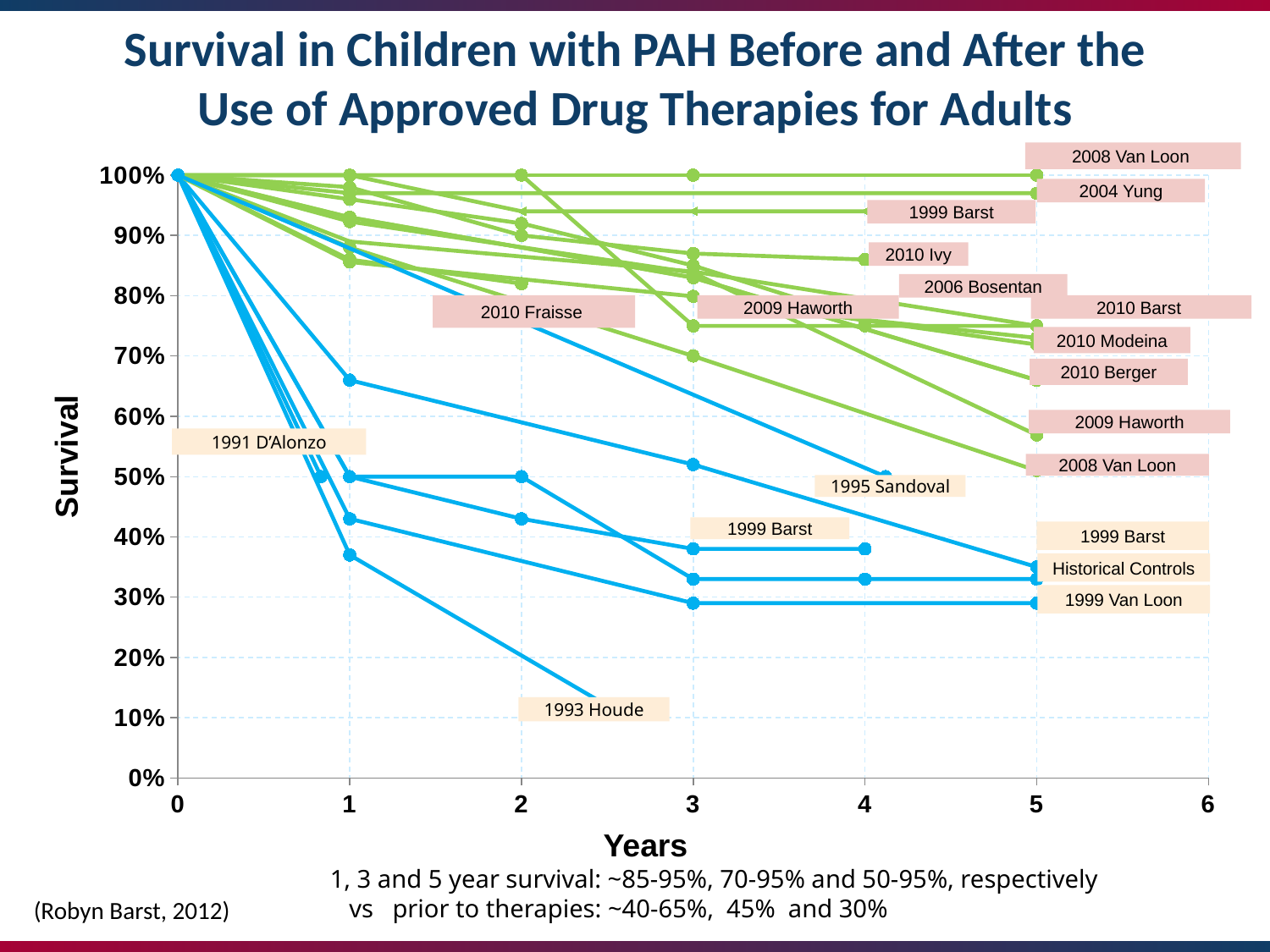
What type of chart is shown on the slide? line chart What survival value do all the series share at year 0? 100% What is the title of the chart? Survival in Children with PAH Before and After the Use of Approved Drug Therapies for Adults Is the survival value for 2010 Ivy at year 4 greater or less than 80%? greater Is the survival value for 1993 Houde at year 1 greater or less than 50%? less Is the survival value for 2010 Berger at year 5 greater or less than 60%? greater At year 5, which has the higher survival: 2004 Yung or 1999 Van Loon? 2004 Yung What are the labels of the x axis and the y axis? Years and Survival What is the survival value at year 5 for the 2008 Van Loon series that stays flat along the top of the chart? 100% Do the blue series rise or fall as the years increase? fall